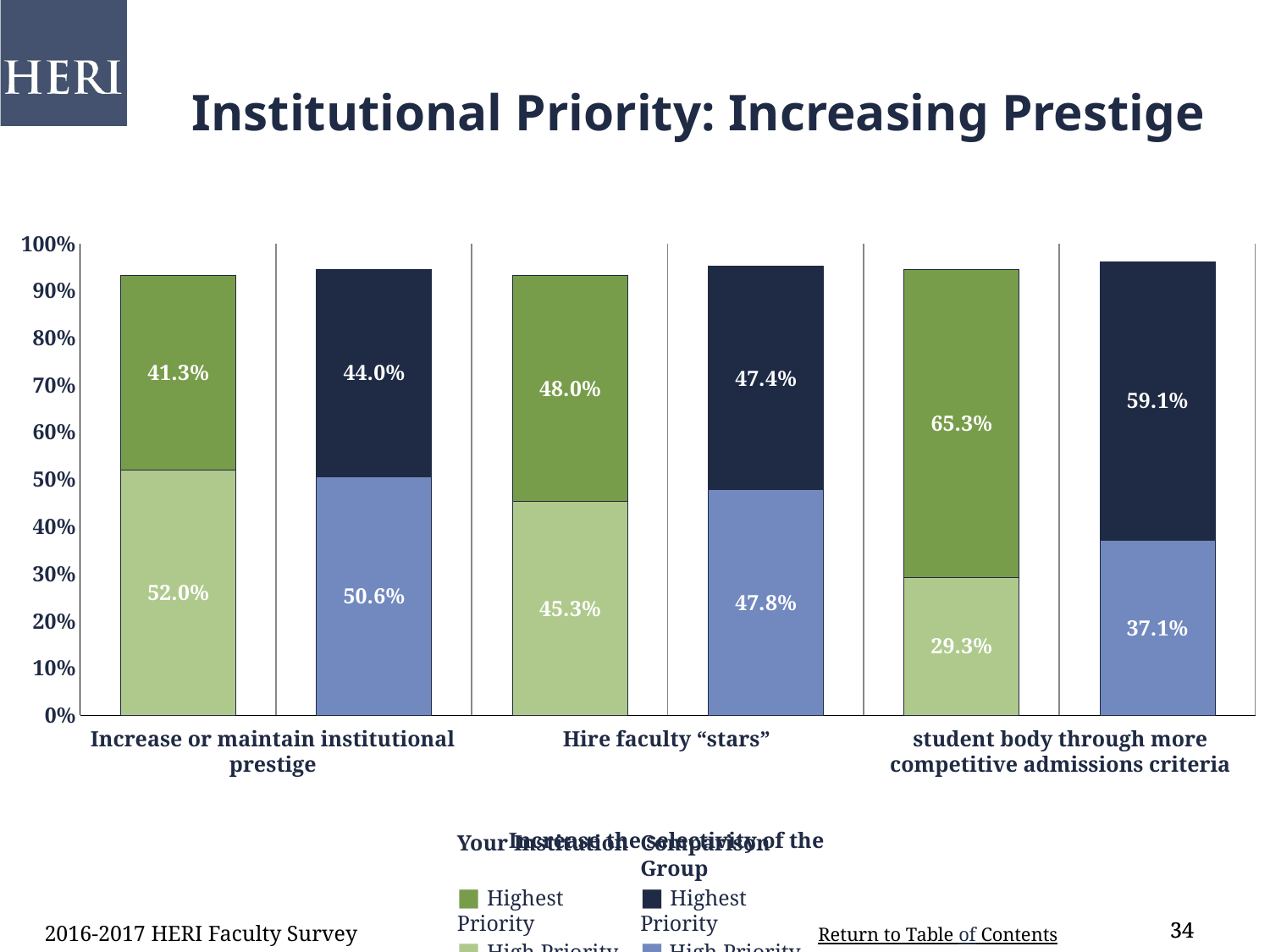
What is the total of the stacked bar for the Comparison Group (blue) in the student body / competitive admissions criteria category? 96.2% Which category has the highest Highest Priority value for Your Institution (green bars)? student body through more competitive admissions criteria What is the Highest Priority value for the Comparison Group (navy bar) for the student body / competitive admissions criteria category? 59.1% What is the difference between the Highest Priority values for Your Institution (65.3%) and the Comparison Group (59.1%) in the student body / competitive admissions criteria category? 6.2% What is the High Priority value for Your Institution (light green bar) for the student body / competitive admissions criteria category? 29.3% How many categories are shown on the x axis of the chart? 3 For "Increase or maintain institutional prestige", which is larger: the Highest Priority value for Your Institution or for the Comparison Group? Comparison Group What is the High Priority value for the Comparison Group (blue bar) for "Increase or maintain institutional prestige"? 50.6% What kind of chart is shown on the slide? Stacked bar chart Which category has the lowest High Priority value for the Comparison Group (light blue bars)? student body through more competitive admissions criteria What is the Highest Priority value for Your Institution (green bar) for "Hire faculty “stars”"? 48.0% What is the total of the stacked bar for Your Institution (green) in the "Increase or maintain institutional prestige" category? 93.3%